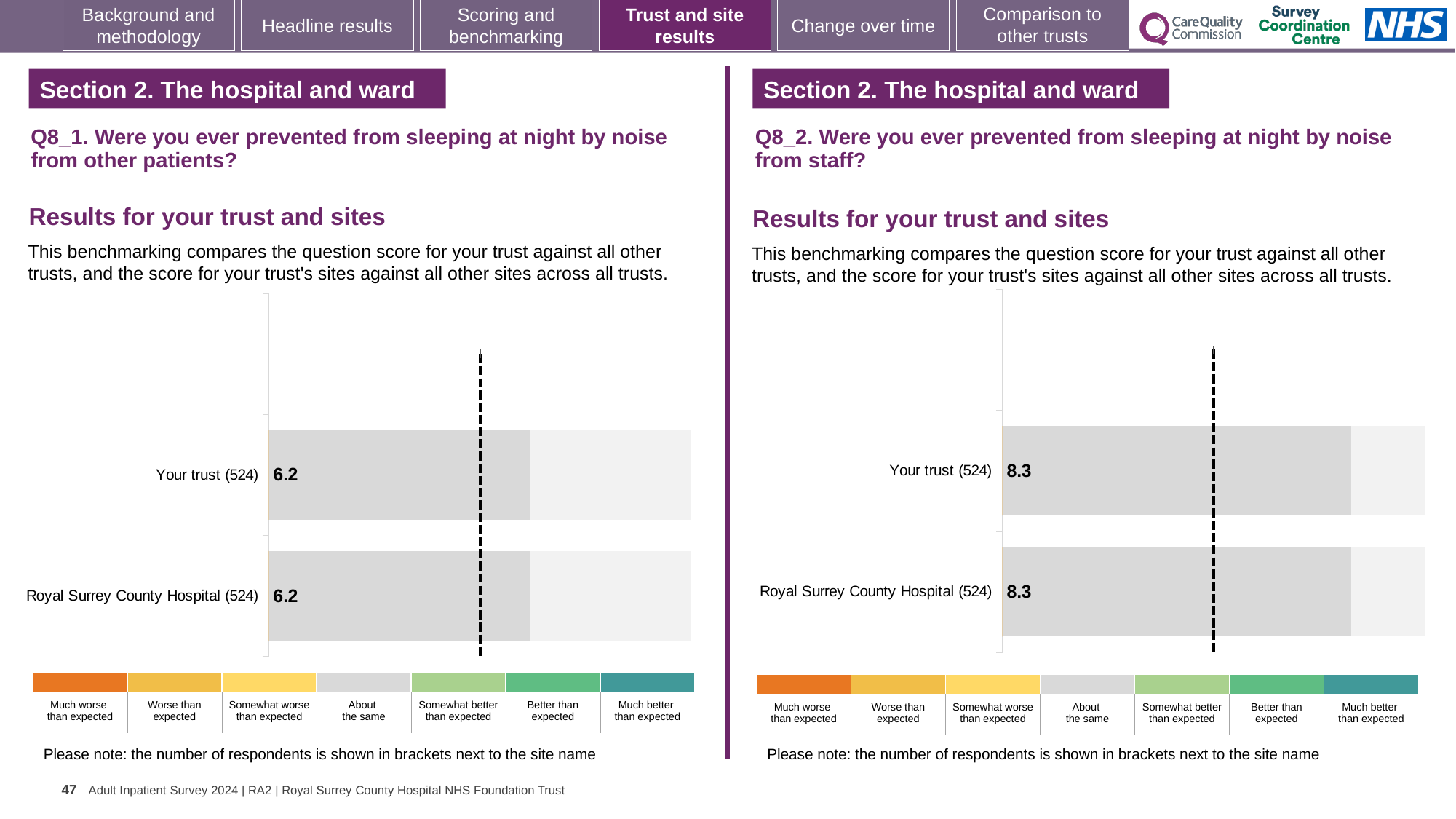
On the right chart (Q8_2), how many respondents are shown in brackets next to Royal Surrey County Hospital? 524 How many bars are plotted on the right chart (Q8_2)? 2 How many rating categories does the colour key below the left chart (Q8_1) list? 7 On the left chart (Q8_1), what is the difference between the Your trust score and the Royal Surrey County Hospital score? 0 How many bars are plotted on the left chart (Q8_1)? 2 On the left chart (Q8_1, noise from other patients), what is the score for Royal Surrey County Hospital? 6.2 On the right chart (Q8_2, noise from staff), what is the score for Your trust? 8.3 On the left chart (Q8_1, noise from other patients), what is the score for Your trust? 6.2 Is the Your trust score higher on the left chart (Q8_1, noise from other patients) or on the right chart (Q8_2, noise from staff)? Q8_2, noise from staff On the right chart (Q8_2, noise from staff), what is the score for Royal Surrey County Hospital? 8.3 What type of chart is used on the left (Q8_1) to show the results for your trust and sites? Bar chart